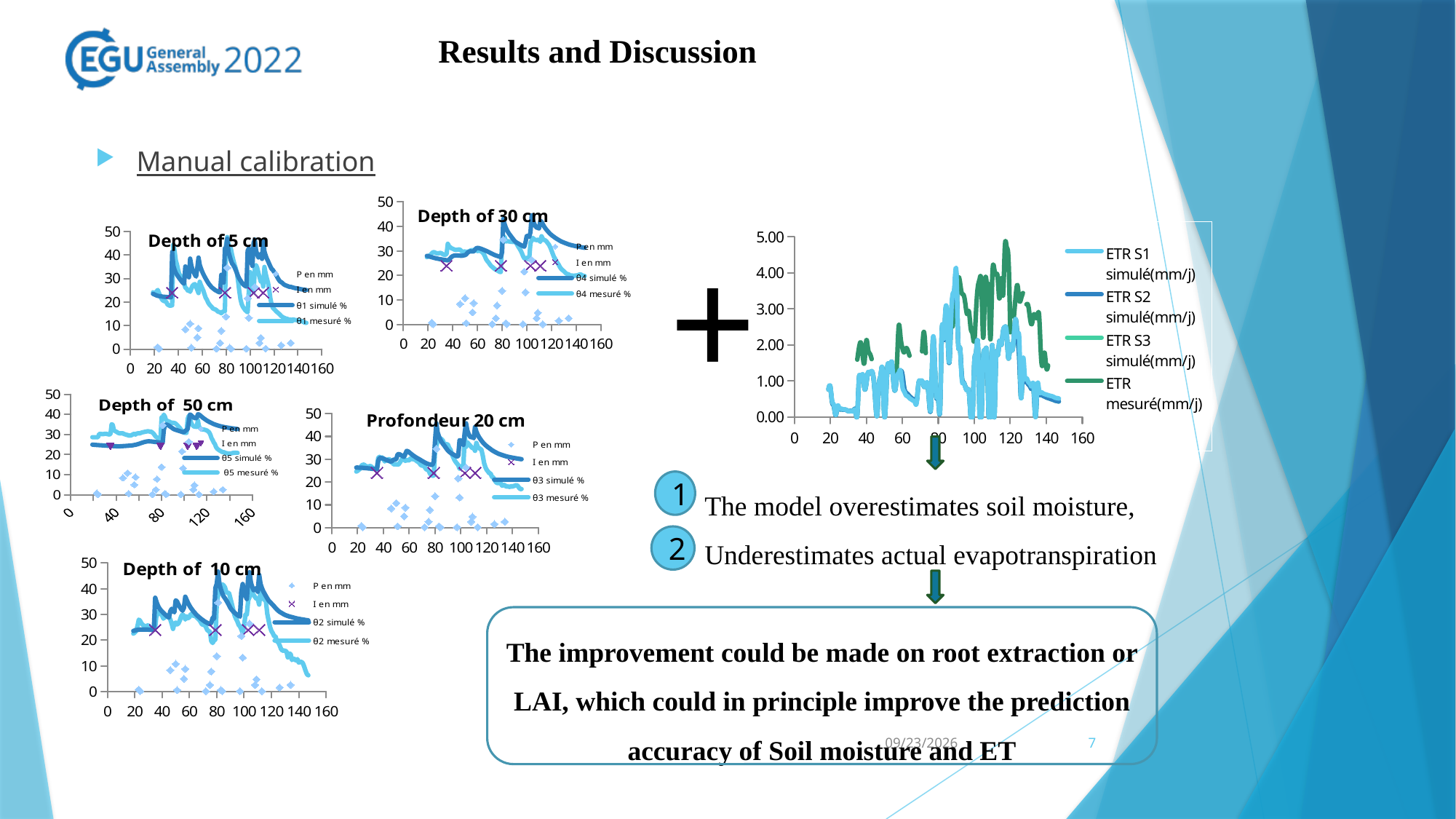
In the ETR chart on the right, is the peak value of ETR mesuré(mm/j) greater or less than 4.00? greater In the ETR chart on the right, is the value of ETR S1 simulé(mm/j) at x = 20 greater or less than 1.00? less What kind of chart is the ETR chart on the right of the slide? line chart In the "Depth of 10 cm" chart, is the value of θ2 simulé % at x = 140 greater or less than 30? less How many charts are shown on the slide? 6 What are the two θ series listed in the legend of the "Depth of 30 cm" chart? θ4 simulé % and θ4 mesuré % How many series does the legend of the "Depth of 5 cm" chart list? 4 How many series does the legend of the ETR chart on the right list? 4 What kind of chart is the "Depth of 5 cm" chart? line chart Which chart on the slide has its title written in French? Profondeur 20 cm